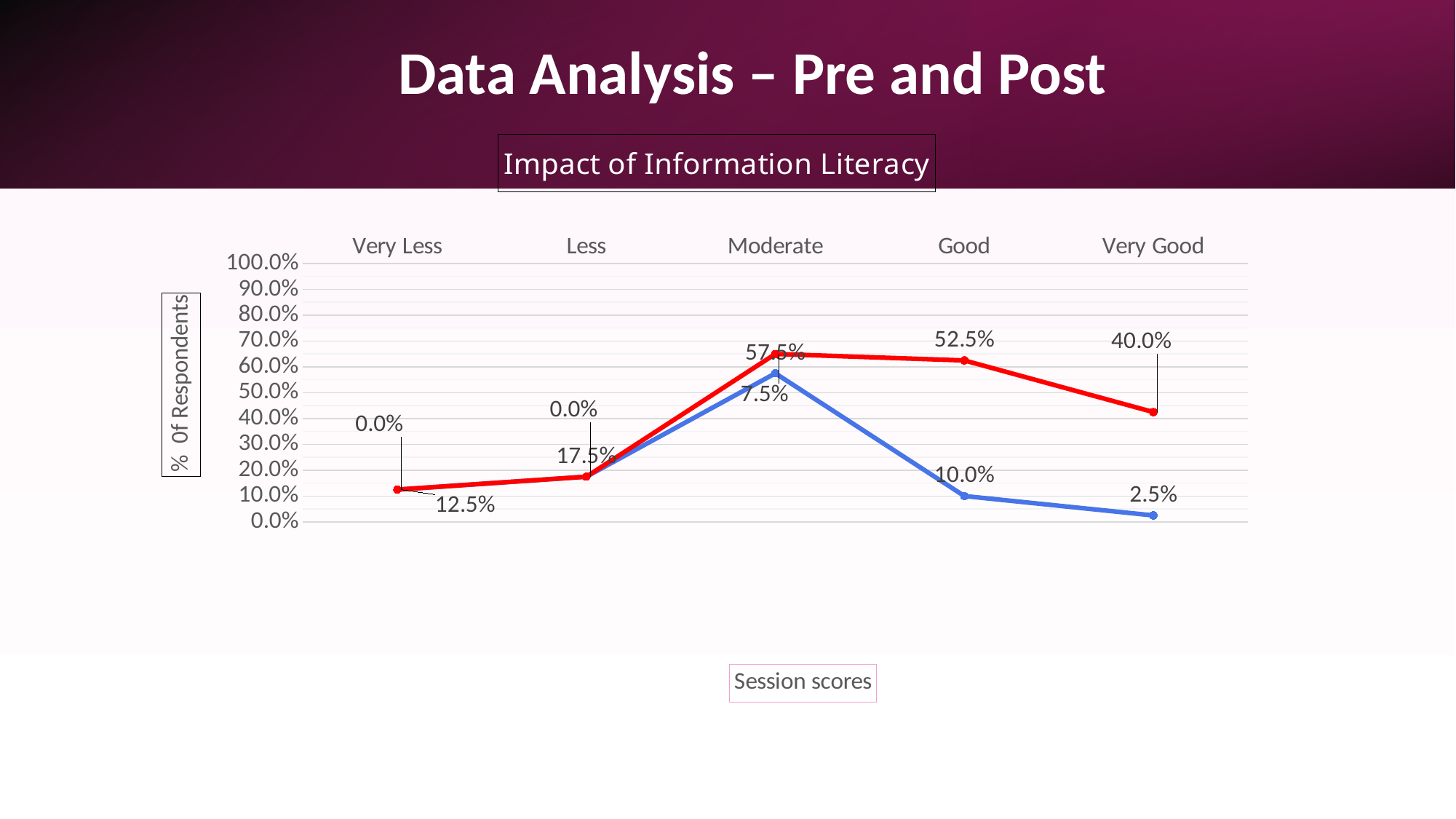
What is the title of the chart? Impact of Information Literacy What is the label on the vertical axis of the chart? % Of Respondents At which category does the blue line reach its highest value? Moderate What is the value of the red line at Less? 0.0% What is the value of the blue line at Good? 10.0% At which category does the blue line have its lowest value? Very Good What is the value of the blue line at Very Good? 2.5% Which line has the larger value at Good, the red line or the blue line? red line What is the value of the red line at Very Less? 0.0% What kind of chart is shown on the slide? line chart How many categories are shown along the x axis of the chart? 5